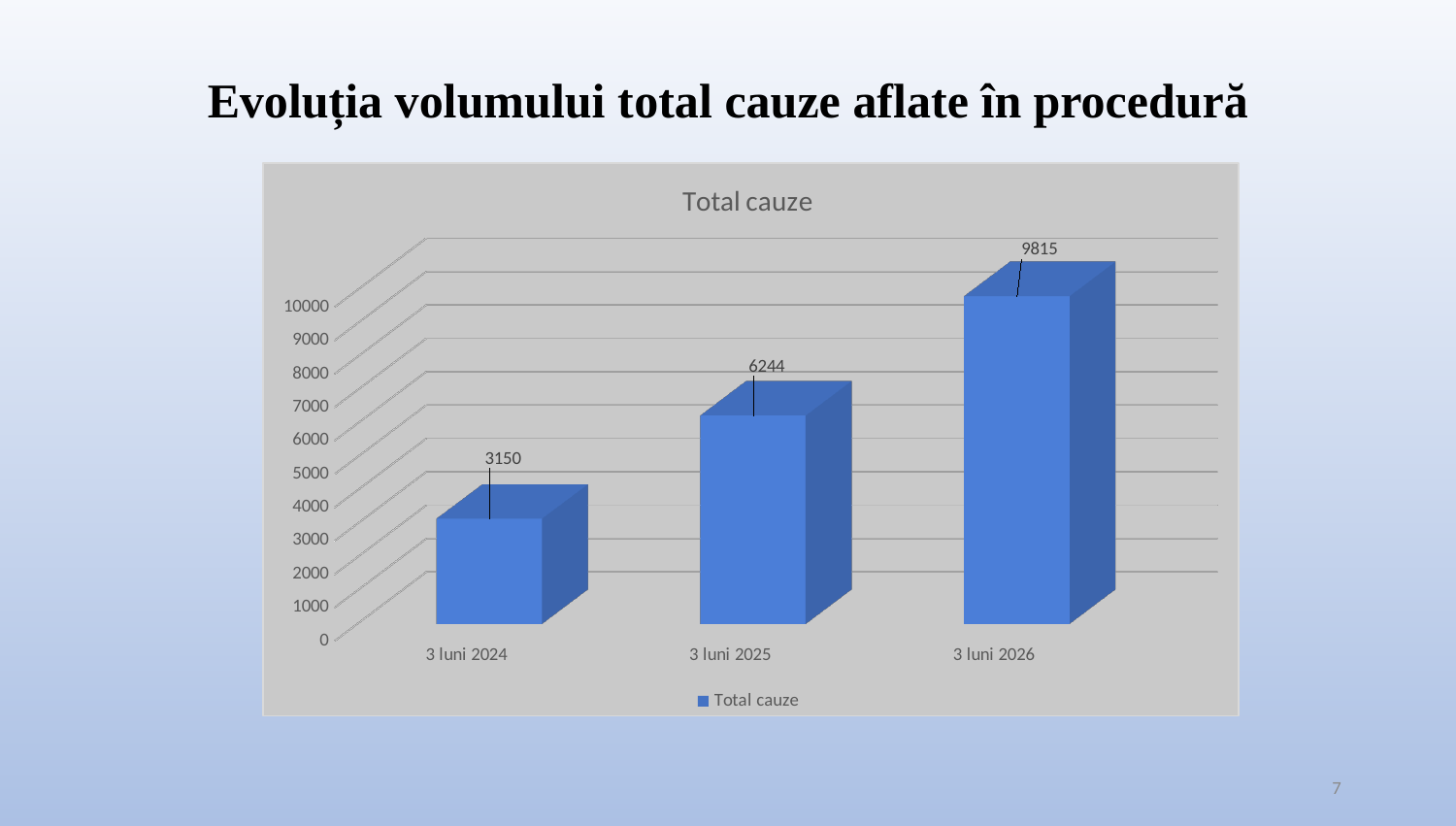
Do the values rise or fall from 3 luni 2024 to 3 luni 2026? rise What is the value for 3 luni 2024? 3150 Which category has the lowest value? 3 luni 2024 What is the value for 3 luni 2025? 6244 What is the value for 3 luni 2026? 9815 Which is larger, the value for 3 luni 2024 or the value for 3 luni 2025? 3 luni 2025 Which category has the highest value? 3 luni 2026 What is the difference between the values for 3 luni 2025 and 3 luni 2024? 3094 How many categories are shown on the x axis? 3 What kind of chart is shown on the slide? bar chart What is the difference between the values for 3 luni 2026 and 3 luni 2025? 3571 How many series does the legend list? 1